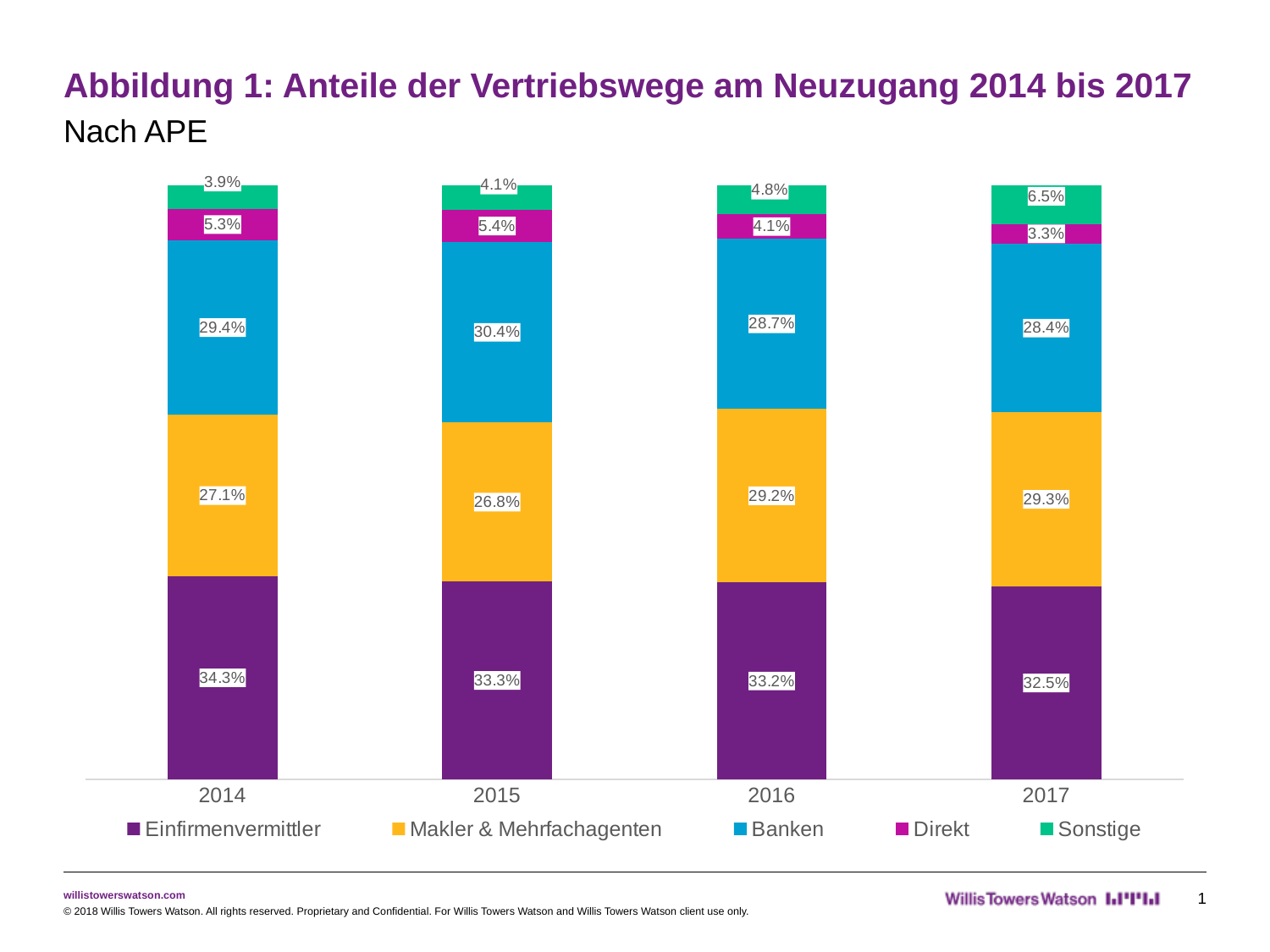
In which year was the share of Direkt lowest? 2017 What is the difference between the Makler & Mehrfachagenten share in 2017 and in 2014? 2.2% What share did Direkt have in 2016? 4.1% How many series does the legend list? 5 What share did Sonstige have in 2017? 6.5% What share did Einfirmenvermittler have in 2014? 34.3% What kind of chart is shown on the slide? Stacked bar chart How many years are shown on the x axis? 4 Does the share of Einfirmenvermittler rise or fall from 2014 to 2017? Fall Which was larger in 2016, the share of Banken or the share of Makler & Mehrfachagenten? Makler & Mehrfachagenten In which year was the share of Einfirmenvermittler highest? 2014 What share did Banken have in 2015? 30.4%